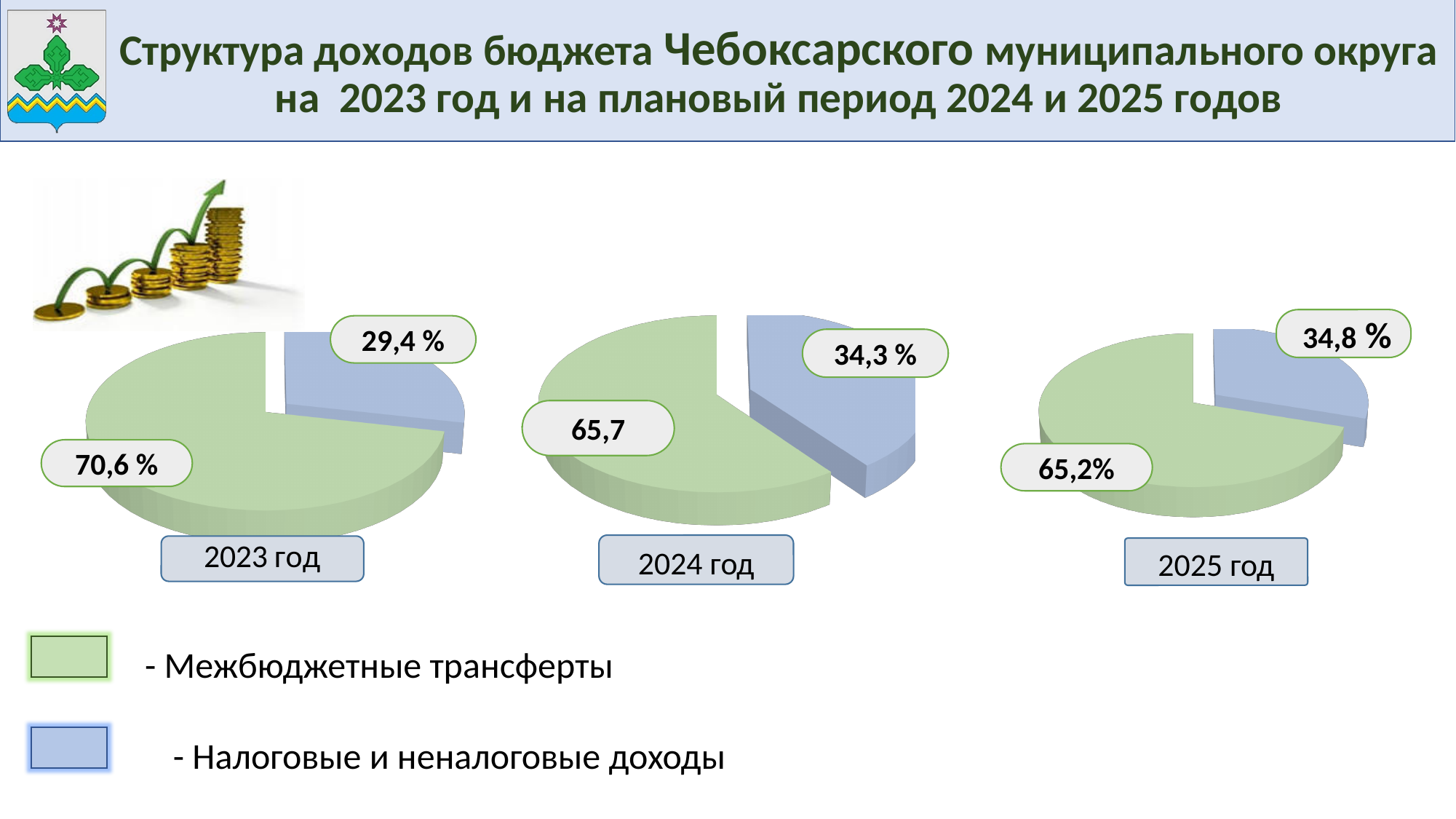
How many pie charts are shown on the slide? 3 In the 2024 год pie chart, what value is labelled on the green Межбюджетные трансферты slice? 65,7 In the 2023 год pie chart, which category has the larger slice? Межбюджетные трансферты In the 2023 год pie chart, what share is shown for Налоговые и неналоговые доходы (blue slice)? 29,4 % In the 2024 год pie chart, what share is shown for Налоговые и неналоговые доходы? 34,3 % How many categories does the legend at the bottom of the slide list? 2 In the 2025 год pie chart, which category has the smaller slice? Налоговые и неналоговые доходы What type of chart is used for each year on the slide? Pie chart Across the three pie charts, does the share of Налоговые и неналоговые доходы rise or fall from 2023 to 2025? Rise In the 2025 год pie chart, what share is shown for Межбюджетные трансферты? 65,2% In the 2023 год pie chart, what share is shown for Межбюджетные трансферты (green slice)? 70,6 % In the 2025 год pie chart, what share is shown for Налоговые и неналоговые доходы? 34,8 %